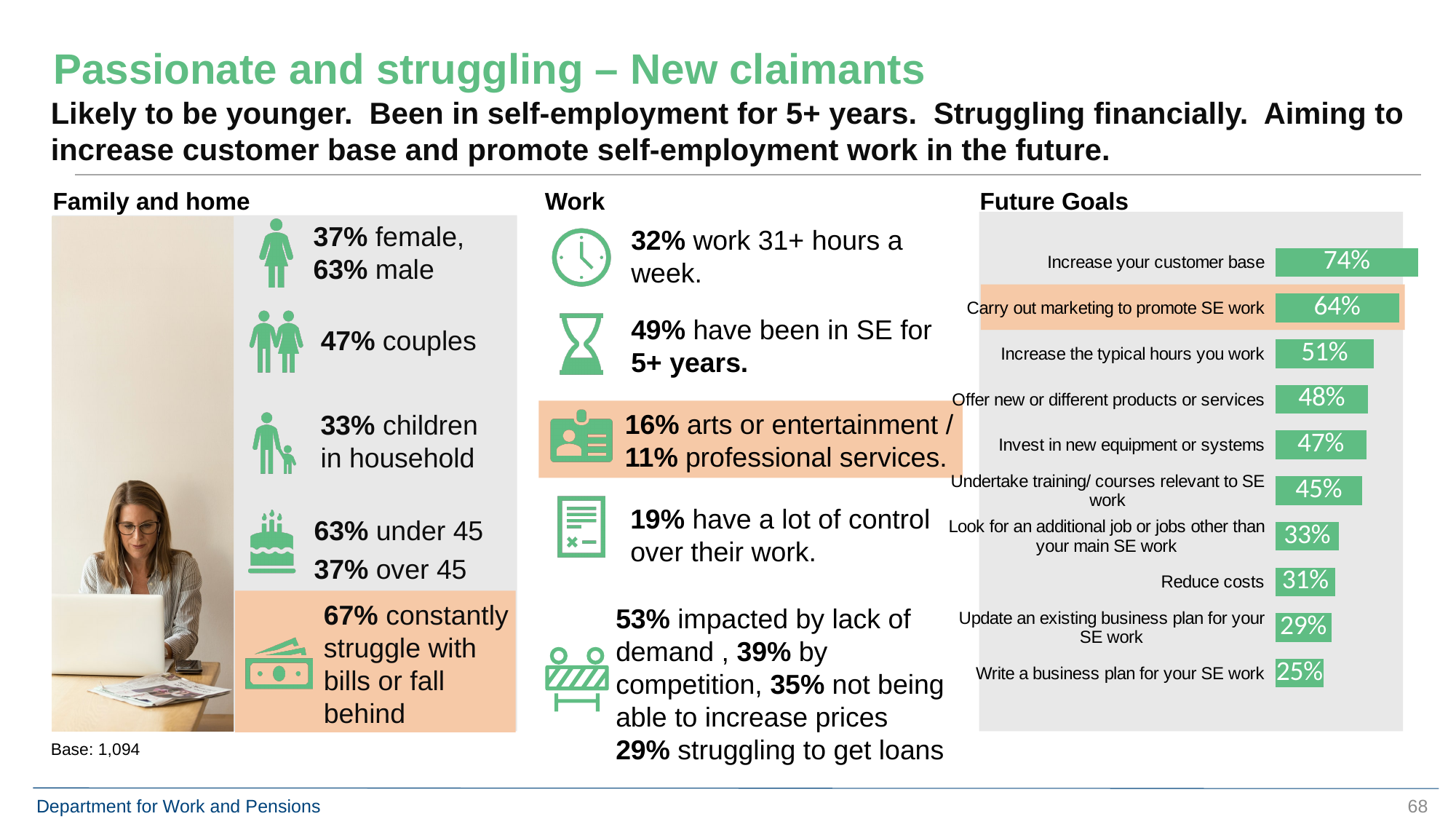
In the Future Goals chart, what is the value for 'Undertake training/ courses relevant to SE work'? 45% How many categories are shown in the Future Goals chart? 10 In the Future Goals chart, which category is highlighted with an orange background? Carry out marketing to promote SE work In the Future Goals chart, which category has the lowest value? Write a business plan for your SE work In the Future Goals chart, what is the value for 'Increase your customer base'? 74% In the Future Goals chart, what is the difference between 'Increase your customer base' and 'Carry out marketing to promote SE work'? 10% In the Future Goals chart, what is the difference between 'Reduce costs' and 'Write a business plan for your SE work'? 6% What type of chart is the Future Goals chart? Bar chart In the Future Goals chart, what is the value for 'Reduce costs'? 31% In the Future Goals chart, which is larger: 'Invest in new equipment or systems' or 'Look for an additional job or jobs other than your main SE work'? Invest in new equipment or systems In the Future Goals chart, what is the value for 'Carry out marketing to promote SE work'? 64% In the Future Goals chart, which category has the highest value? Increase your customer base